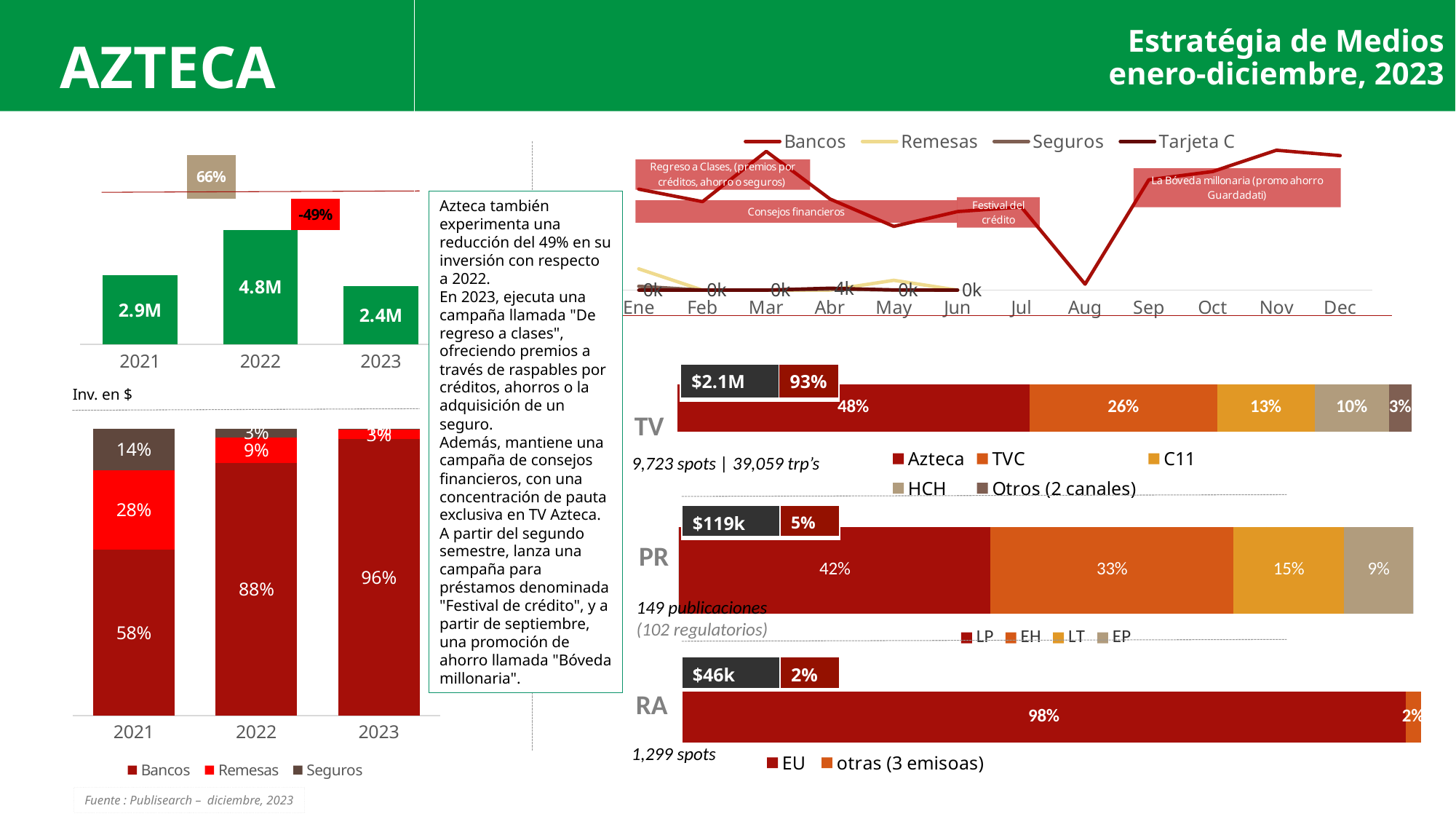
In the top-left bar chart of yearly investment, what is the value for 2022? 4.8M In the top-right line chart, how many series does the legend list? 4 In the top-left bar chart of yearly investment, what percentage change is labelled between 2022 and 2023? -49% In the PR stacked bar chart, what is the difference between the LP share and the EH share? 9% In the top-left bar chart of yearly investment, which year has the lowest value? 2023 In the TV stacked bar chart, which channel has the largest share? Azteca What type of chart is the top-right chart showing monthly values from Ene to Dec? Line chart In the RA stacked bar chart, what share does EU have? 98% In the bottom-left stacked bar chart (Inv. en $), what is the share for Remesas in 2021? 28% In the bottom-left stacked bar chart (Inv. en $), what is the difference between the Bancos share in 2023 and in 2021? 38% In the TV stacked bar chart, what share does TVC have? 26% In the bottom-left stacked bar chart (Inv. en $), how many series does the legend list? 3